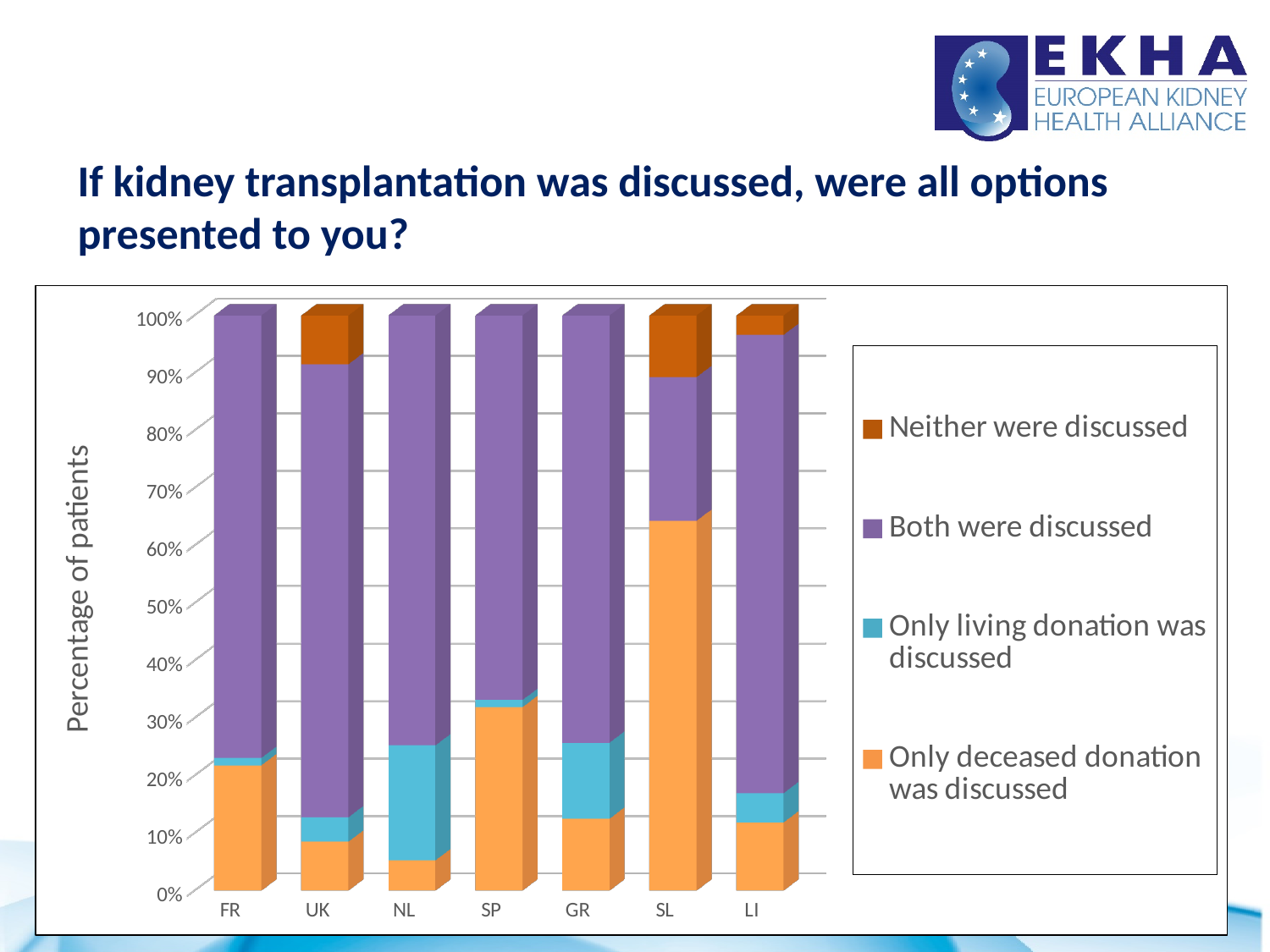
Which country has the largest share for 'Only deceased donation was discussed'? SL How many countries are shown along the x axis of the chart? 7 Is the 'Only deceased donation was discussed' value for SL greater or less than 60%? greater Is the 'Only deceased donation was discussed' value for SP greater or less than 20%? greater What kind of chart is shown on the slide? Stacked bar chart Which country has the largest share for 'Only living donation was discussed'? NL Which legend entry is shown in purple? Both were discussed Is the 'Both were discussed' share larger for FR or for SL? FR How many series does the chart's legend list? 4 Is the 'Only deceased donation was discussed' value for FR greater or less than 30%? less What is the label on the vertical axis of the chart? Percentage of patients Which country has the smallest share for 'Both were discussed'? SL